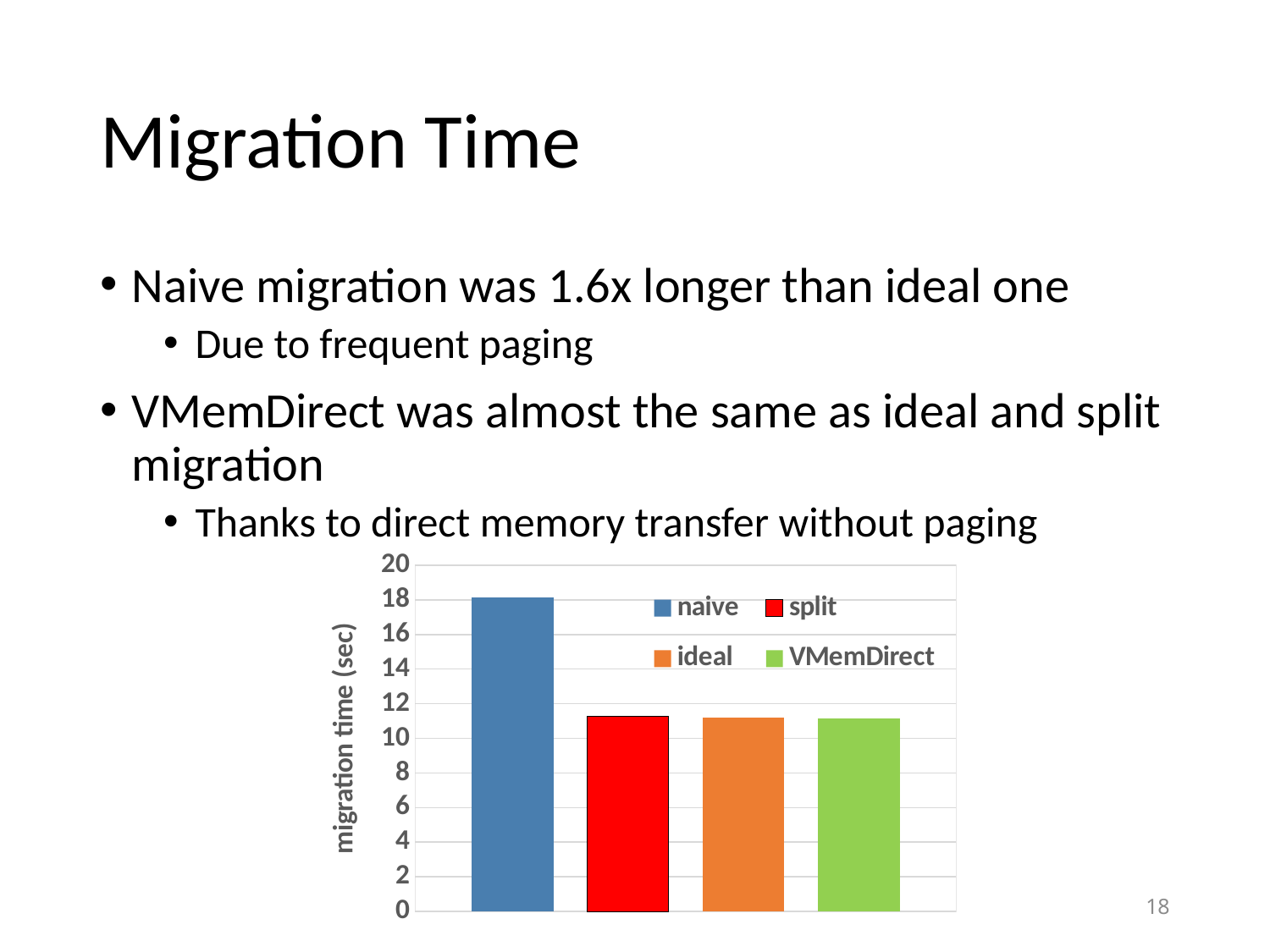
Which series has the highest migration time? naive Which has a larger migration time, ideal or naive? naive Is the migration time for ideal greater or less than 10? greater Is the migration time for VMemDirect greater or less than 14? less What is the maximum value shown on the chart's vertical axis? 20 What is the label of the chart's vertical axis? migration time (sec) How many bars are plotted in the chart? 4 What kind of chart is shown on the slide? bar chart Is the migration time for naive greater or less than 16? greater Which has a larger migration time, naive or VMemDirect? naive How many series does the chart's legend list? 4